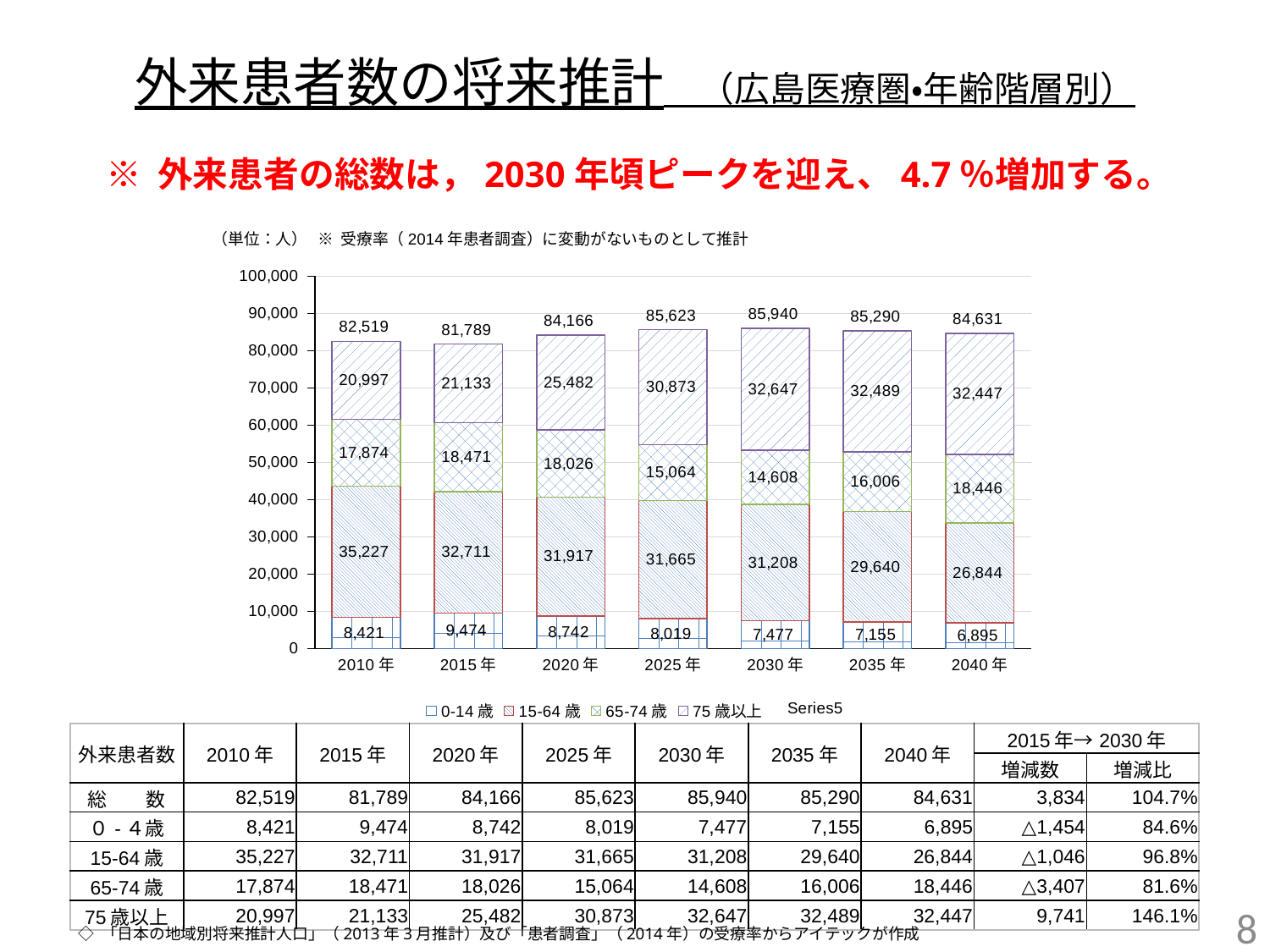
How many years (categories) are plotted along the x axis of the chart? 7 Is the total for 2020年 greater or less than 80,000? greater What is the value of the 15-64歳 segment for 2010年? 35,227 What type of chart is shown on the slide? stacked bar chart What is the value of the 0-14歳 segment for 2015年? 9,474 Which year has the highest total outpatient count? 2030年 What is the value of the 75歳以上 segment for 2040年? 32,447 Which is larger, the 65-74歳 segment in 2025年 or the 65-74歳 segment in 2040年? 2040年 What is the difference between the total for 2030年 and the total for 2015年? 4,151 What is the total outpatient count shown above the bar for 2030年? 85,940 Which year has the lowest total outpatient count? 2015年 How many entries does the chart legend list? 5